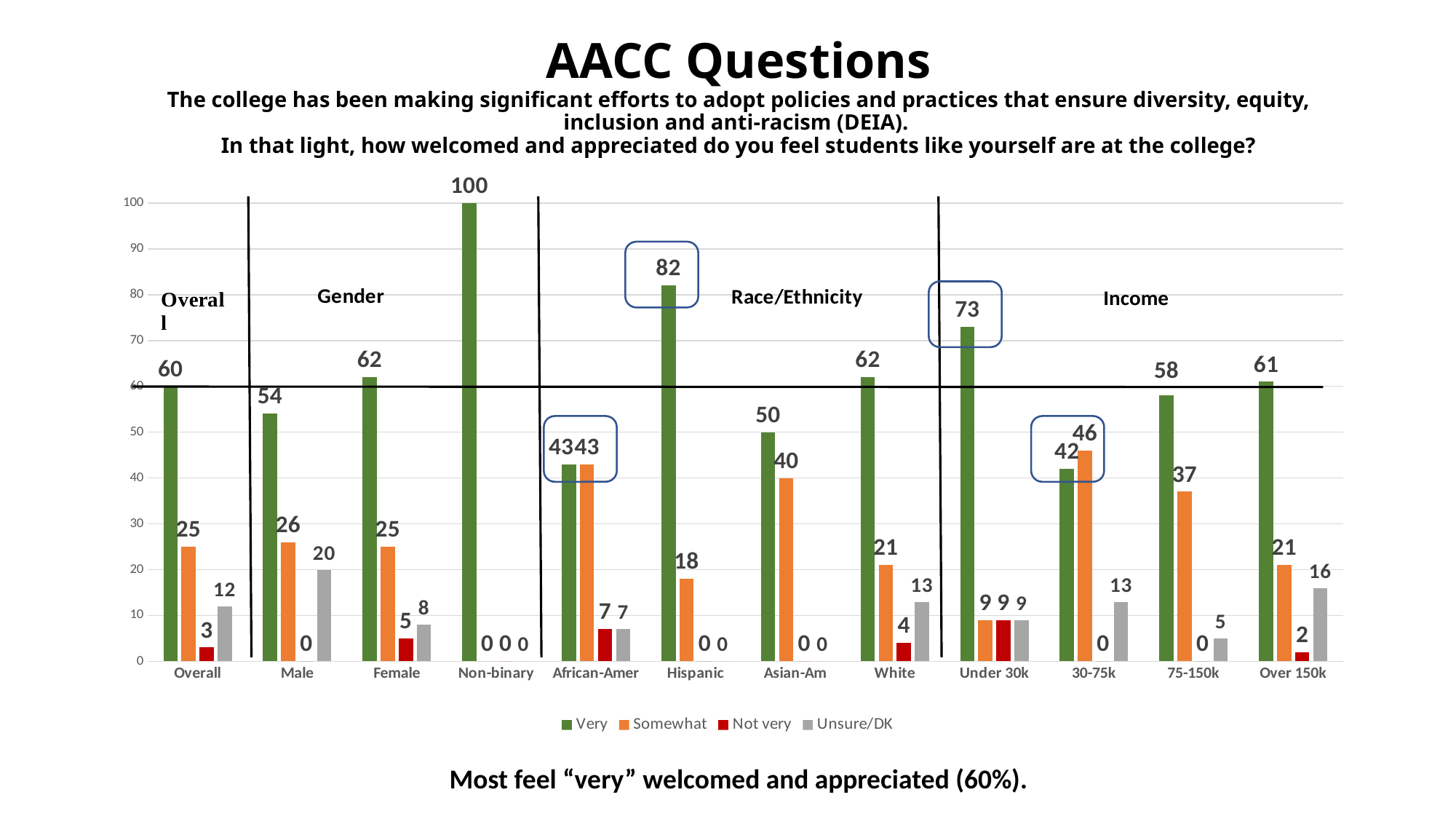
Which category has the lowest "Very" value? 30-75k Which category has the highest "Very" value? Non-binary What is the "Unsure/DK" value for Male? 20 How many categories are shown on the x axis? 12 What is the "Very" value for Hispanic? 82 What is the difference between the "Very" values for Hispanic and Asian-Am? 32 What is the "Not very" value for Under 30k? 9 What is the "Somewhat" value for 30-75k? 46 Which colour represents the "Not very" series? Red What kind of chart is shown on the slide? Bar chart Which is larger for 30-75k, the "Very" value or the "Somewhat" value? Somewhat How many series does the legend list? 4